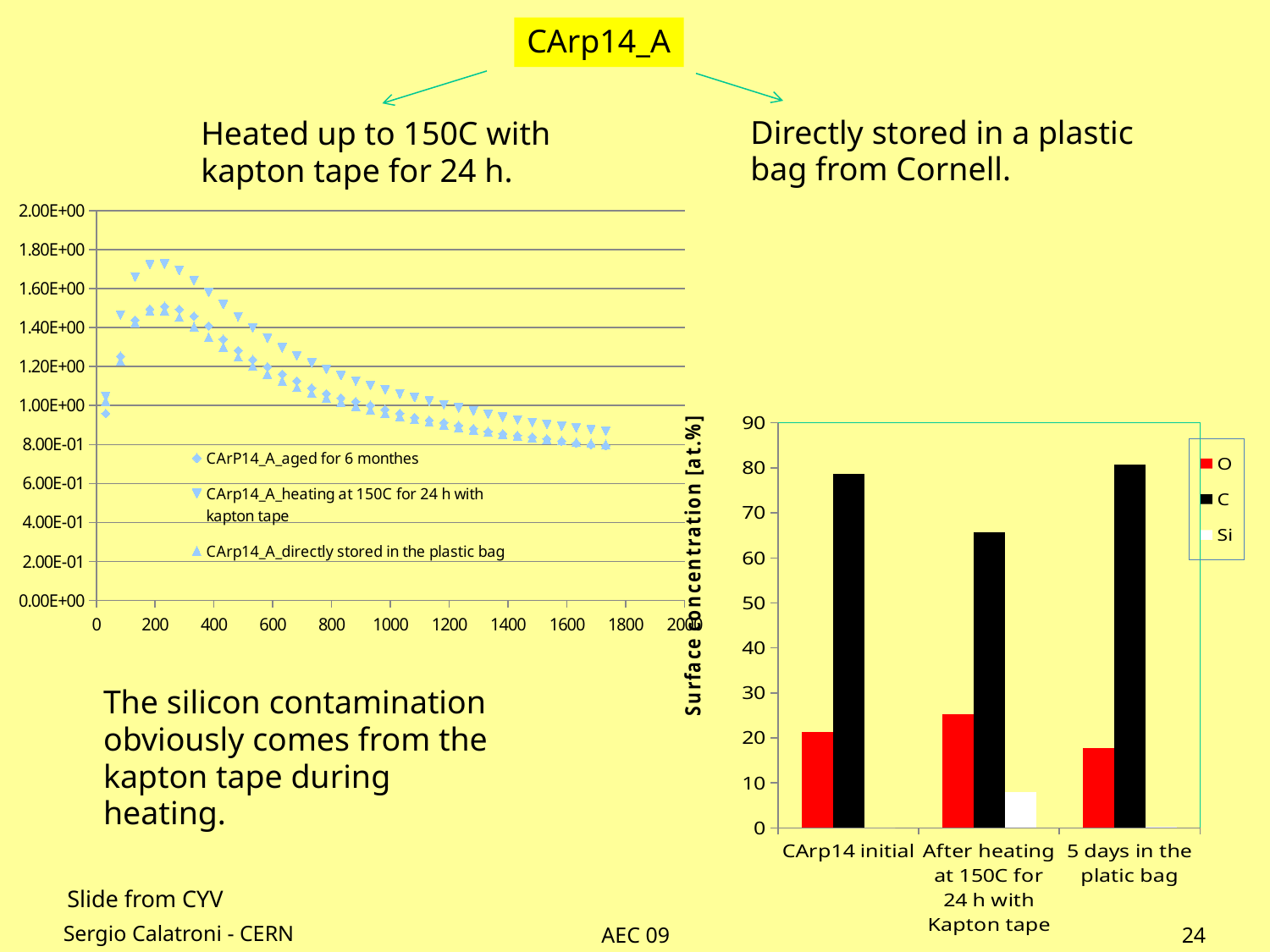
How many series does the legend of the left-hand scatter chart list? 3 How many series does the legend of the right-hand bar chart list? 3 In the right-hand bar chart, which category has the lowest value for C? After heating at 150C for 24 h with Kapton tape In the right-hand bar chart, is the value for O in the 'After heating at 150C for 24 h with Kapton tape' category greater or less than 20? greater In the right-hand bar chart, which category is the only one with a visible Si bar? After heating at 150C for 24 h with Kapton tape In the right-hand bar chart, is the value for C in the 'After heating at 150C for 24 h with Kapton tape' category greater or less than 70? less What is the y-axis title of the right-hand bar chart? Surface concentration [at.%] In the right-hand bar chart, which is larger: O for 'After heating at 150C for 24 h with Kapton tape' or O for '5 days in the platic bag'? After heating at 150C for 24 h with Kapton tape What kind of chart is the chart on the right of the slide? bar chart In the right-hand bar chart, is the value for Si in the 'After heating at 150C for 24 h with Kapton tape' category greater or less than 10? less What kind of chart is the chart on the left of the slide? scatter chart How many categories are shown on the x axis of the right-hand bar chart? 3